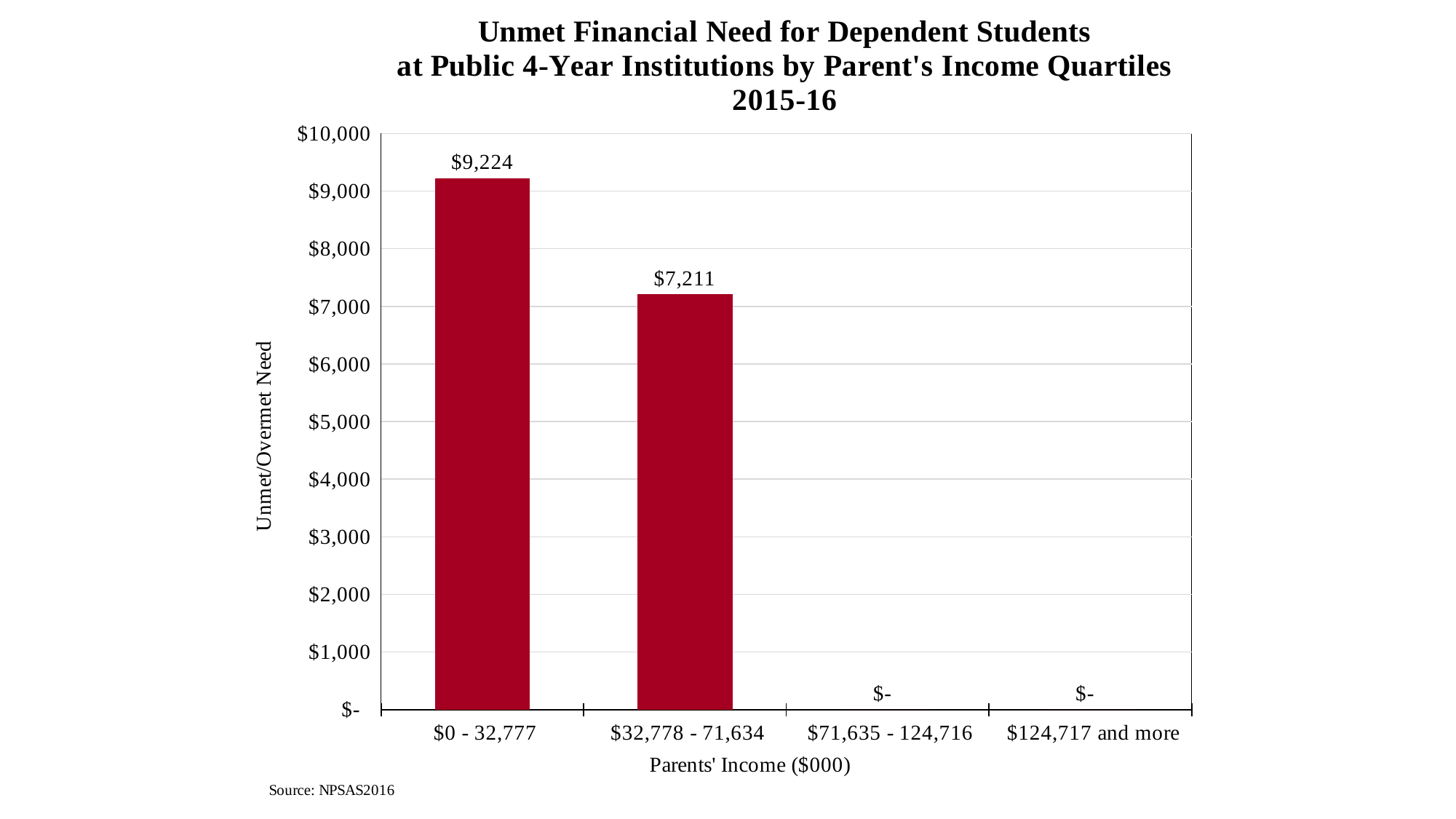
Which is larger, the unmet need for $0 - 32,777 or for $32,778 - 71,634? $0 - 32,777 What is the difference in unmet financial need between the $0 - 32,777 and $32,778 - 71,634 quartiles? $2,013 What value is shown for the $71,635 - 124,716 income quartile? $- What is the label of the y axis? Unmet/Overmet Need What kind of chart is shown on the slide? bar chart Do the values rise or fall as parents' income increases along the x axis? fall What is the unmet financial need for the $0 - 32,777 parents' income quartile? $9,224 How many income quartile categories are shown on the x axis? 4 Is the value for the $0 - 32,777 quartile greater or less than $9,000? greater What is the unmet financial need for the $32,778 - 71,634 parents' income quartile? $7,211 Which income quartile has the highest unmet financial need? $0 - 32,777 Is the value for the $32,778 - 71,634 quartile greater or less than $8,000? less